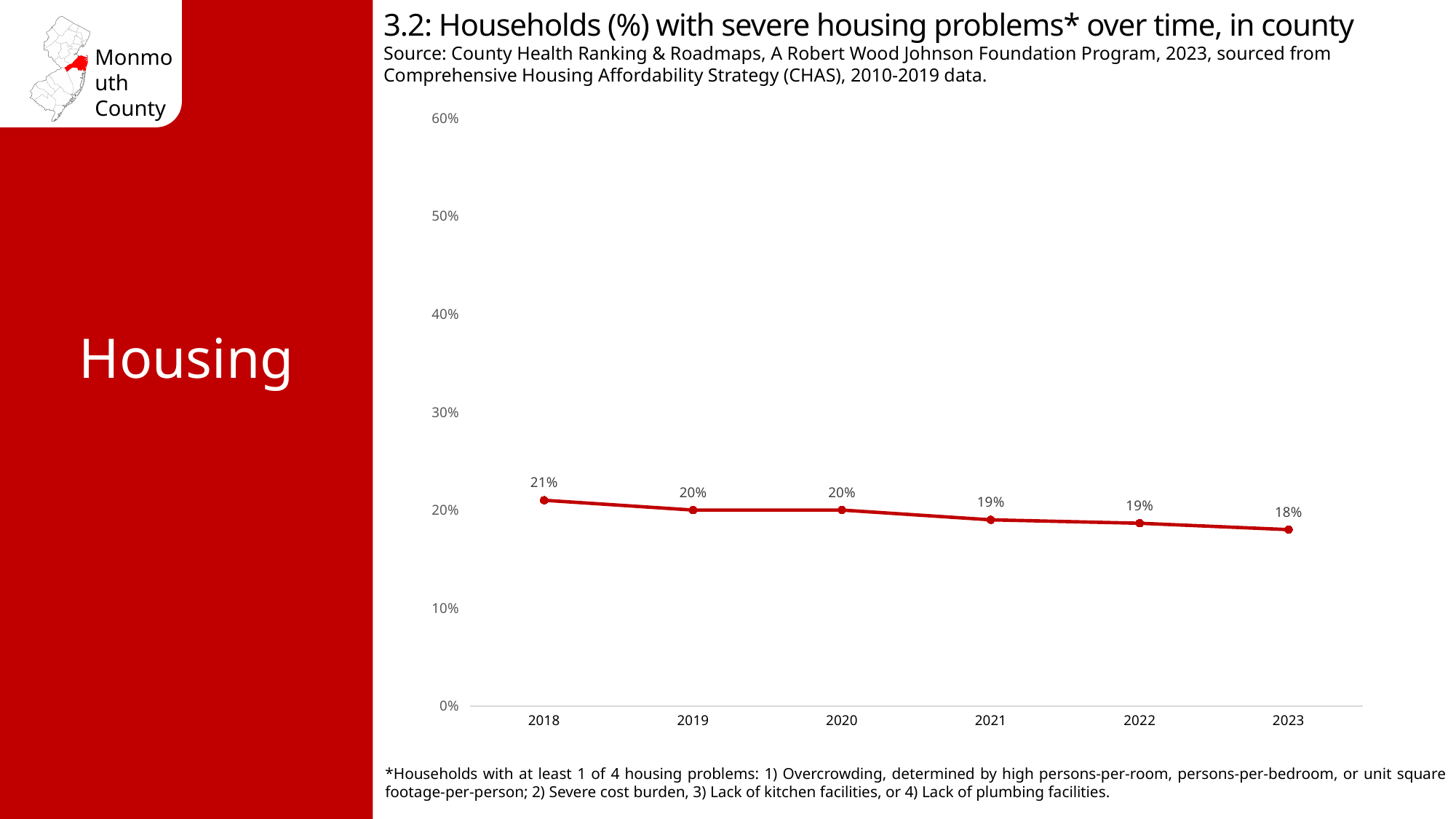
Which year has the lowest percentage of households with severe housing problems? 2023 What is the title of the chart? 3.2: Households (%) with severe housing problems* over time, in county Is the value for 2020 greater or less than 30%? less What is the value shown for 2023? 18% What is the difference between the 2018 value and the 2023 value? 3% What kind of chart is shown on the slide? line chart How many years are plotted on the chart? 6 Do the values rise or fall from 2018 to 2023? fall What percentage of households had severe housing problems in 2018? 21% Which is larger, the value for 2019 or the value for 2023? 2019 What value is plotted for 2021? 19% Which year has the highest percentage of households with severe housing problems? 2018